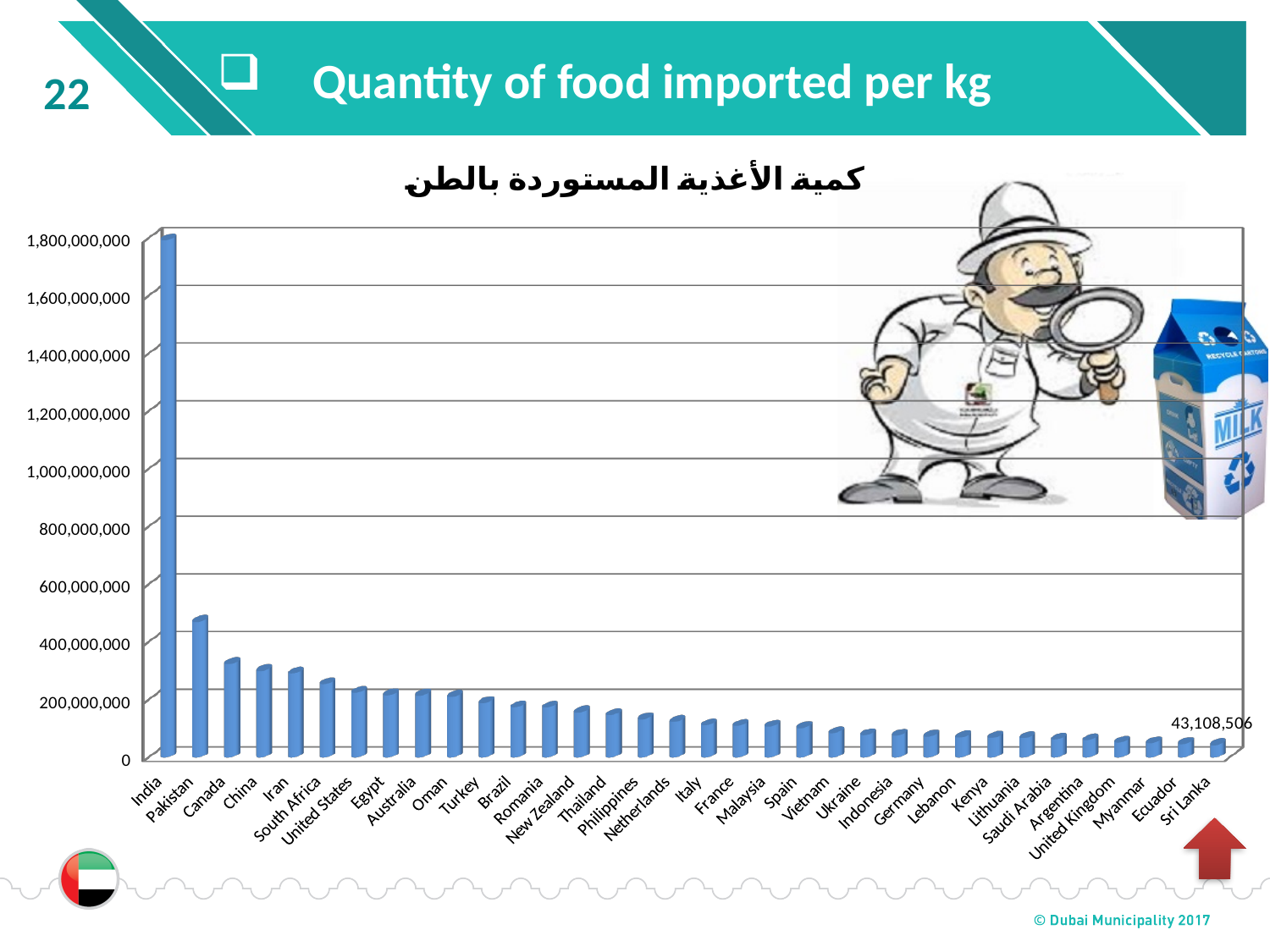
What is the value shown for Sri Lanka? 43,108,506 Is the value for Canada greater or less than 200,000,000? greater What is the English title of the slide? Quantity of food imported per kg How many countries are shown on the x axis? 34 Is the value for Pakistan greater or less than 400,000,000? greater What kind of chart is shown on the slide? Bar chart Is the value for India greater or less than 1,600,000,000? greater Which country has the lowest quantity of food imported? Sri Lanka Do the values rise or fall moving from left to right along the x axis? Fall Which is larger, the value for India or the value for Pakistan? India Which country has the highest quantity of food imported? India